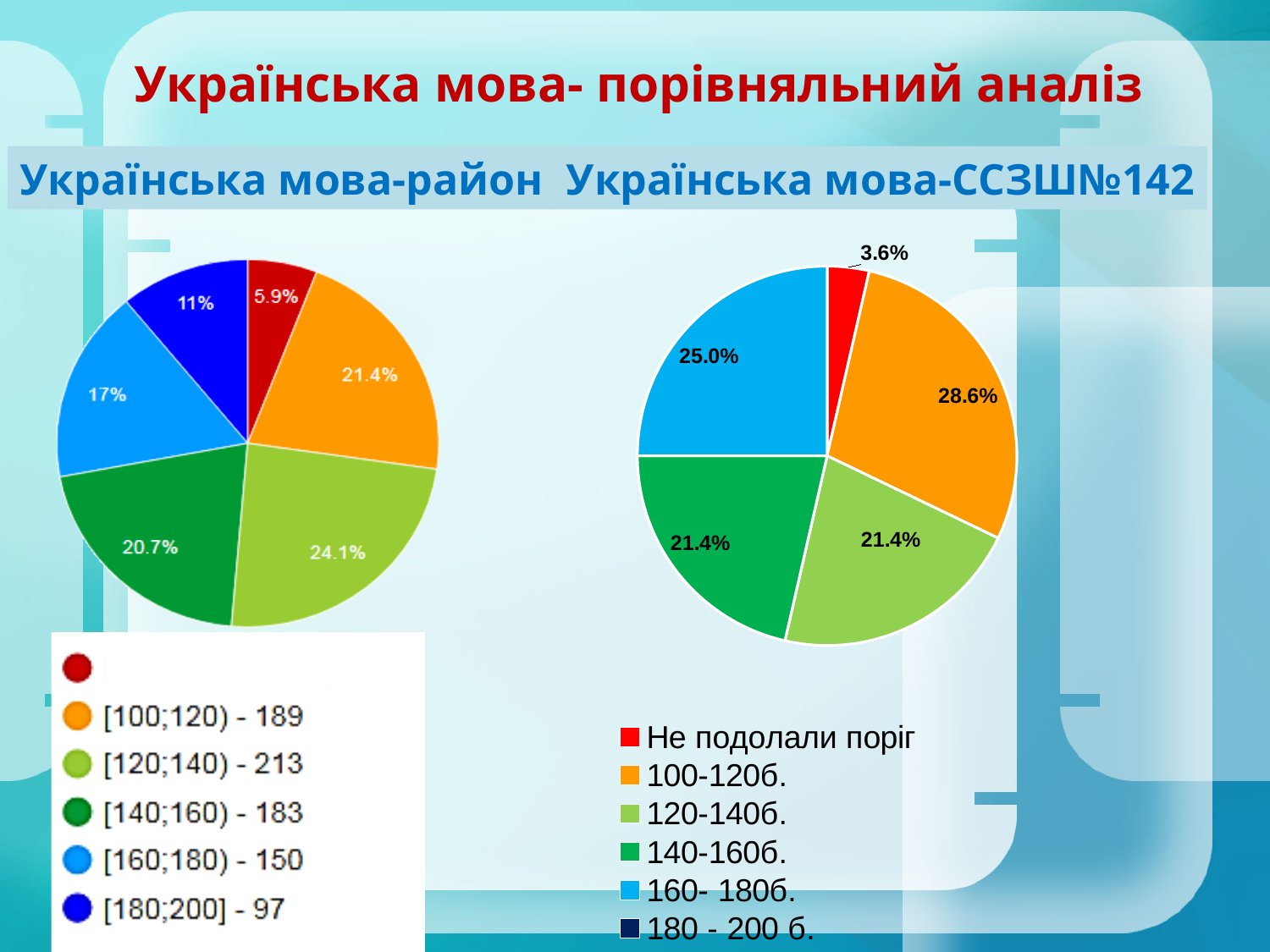
In the "Українська мова-район" chart, what share does the "[120;140) - 213" slice have? 24.1% What kind of chart is used for "Українська мова-район"? pie chart In the "Українська мова-ССЗШ№142" chart, what is the difference between the "100-120б." share and the "160- 180б." share? 3.6% In the "Українська мова-ССЗШ№142" chart, what share does the "Не подолали поріг" slice have? 3.6% In the "Українська мова-район" chart, which category has the largest slice? [120;140) - 213 In the "Українська мова-район" chart, what share does the "[180;200] - 97" slice have? 11% In the "Українська мова-район" chart, which is larger: the "[140;160) - 183" slice or the "[160;180) - 150" slice? [140;160) - 183 In the "Українська мова-ССЗШ№142" chart, which category has the largest slice? 100-120б. In the "Українська мова-ССЗШ№142" chart, which labelled slice is the smallest? Не подолали поріг How many entries does the legend of the "Українська мова-ССЗШ№142" chart list? 6 In the "Українська мова-ССЗШ№142" chart, what share does the "160- 180б." slice have? 25.0% In the "Українська мова-ССЗШ№142" chart, what share does the "100-120б." slice have? 28.6%